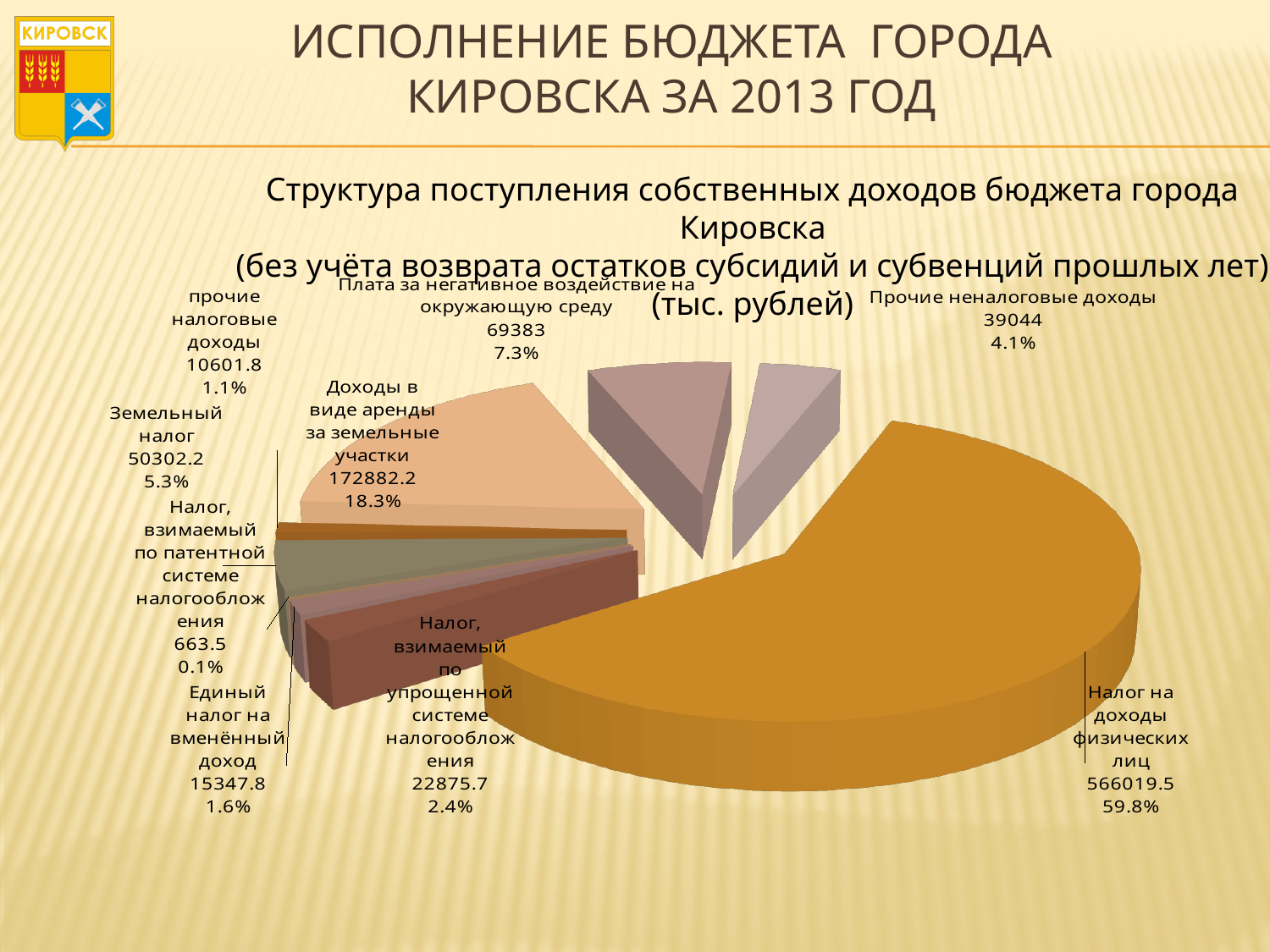
What is the value for Земельный налог? 50302.2 What is the value for Налог на доходы физических лиц? 566019.5 What kind of chart is shown on the slide? pie chart Which category has the largest slice of the pie? Налог на доходы физических лиц What share of the pie does Прочие неналоговые доходы represent? 4.1% How many categories (slices) does the pie chart show? 9 What is the value for Доходы в виде аренды за земельные участки? 172882.2 In what units are the values on the chart given, according to the chart title? тыс. рублей What is the difference between the values for Единый налог на вменённый доход and прочие налоговые доходы? 4746 Which category has the smallest slice of the pie? Налог, взимаемый по патентной системе налогообложения What share of the pie does Плата за негативное воздействие на окружающую среду represent? 7.3% Which is larger: the value for Земельный налог or the value for Прочие неналоговые доходы? Земельный налог